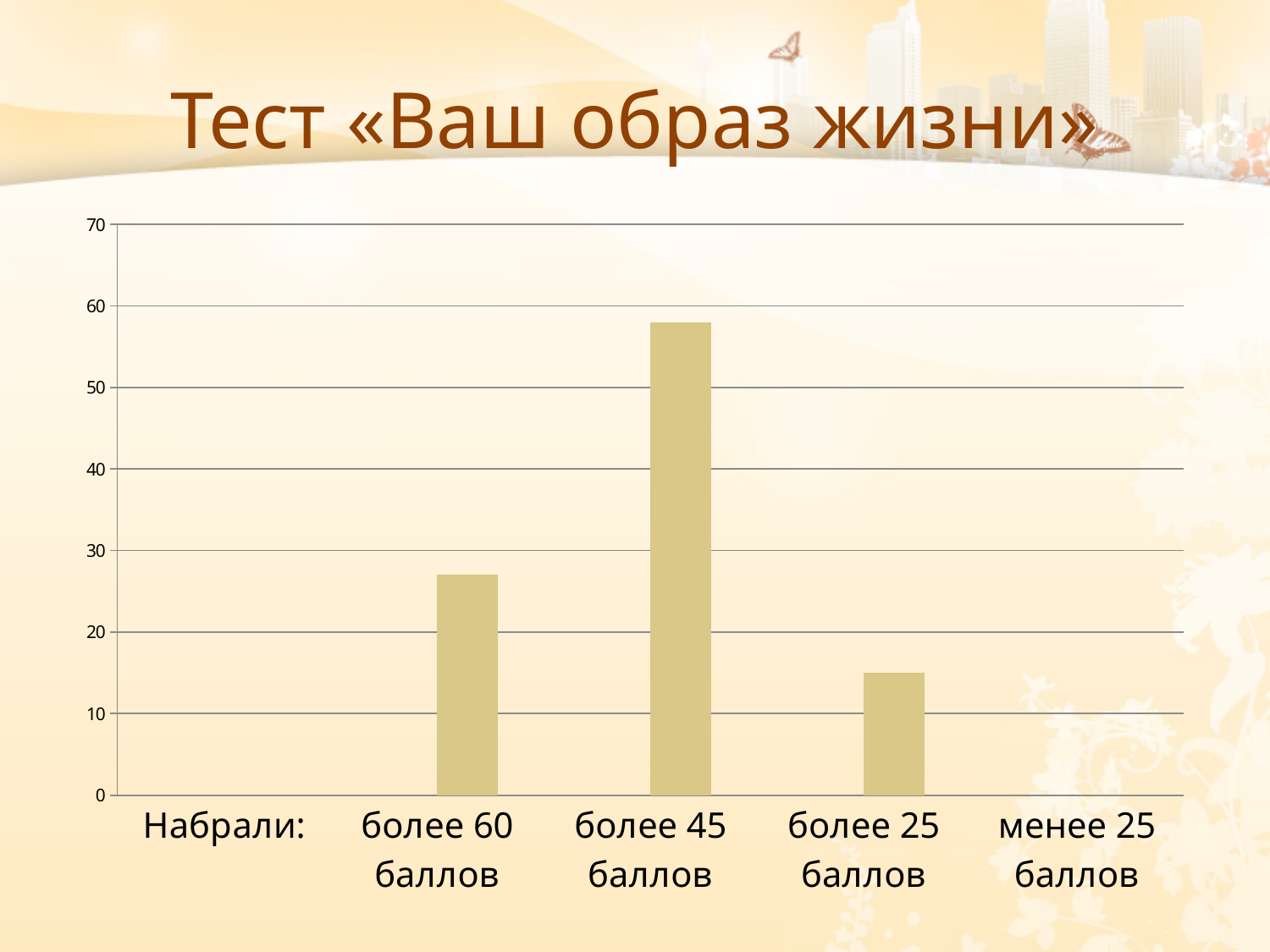
How many category labels are shown along the x axis? 5 Which is larger, the value for «более 45 баллов» or for «более 60 баллов»? более 45 баллов Is the value for «более 45 баллов» greater or less than 60? less Is the value for «более 25 баллов» greater or less than 20? less What is the title of the slide with the chart? Тест «Ваш образ жизни» Is the value for «более 60 баллов» greater or less than 30? less What kind of chart is shown on the slide? bar chart Which category has the tallest bar? более 45 баллов Which of the three visible bars is the shortest? более 25 баллов Which is larger, the value for «более 60 баллов» or for «более 25 баллов»? более 60 баллов